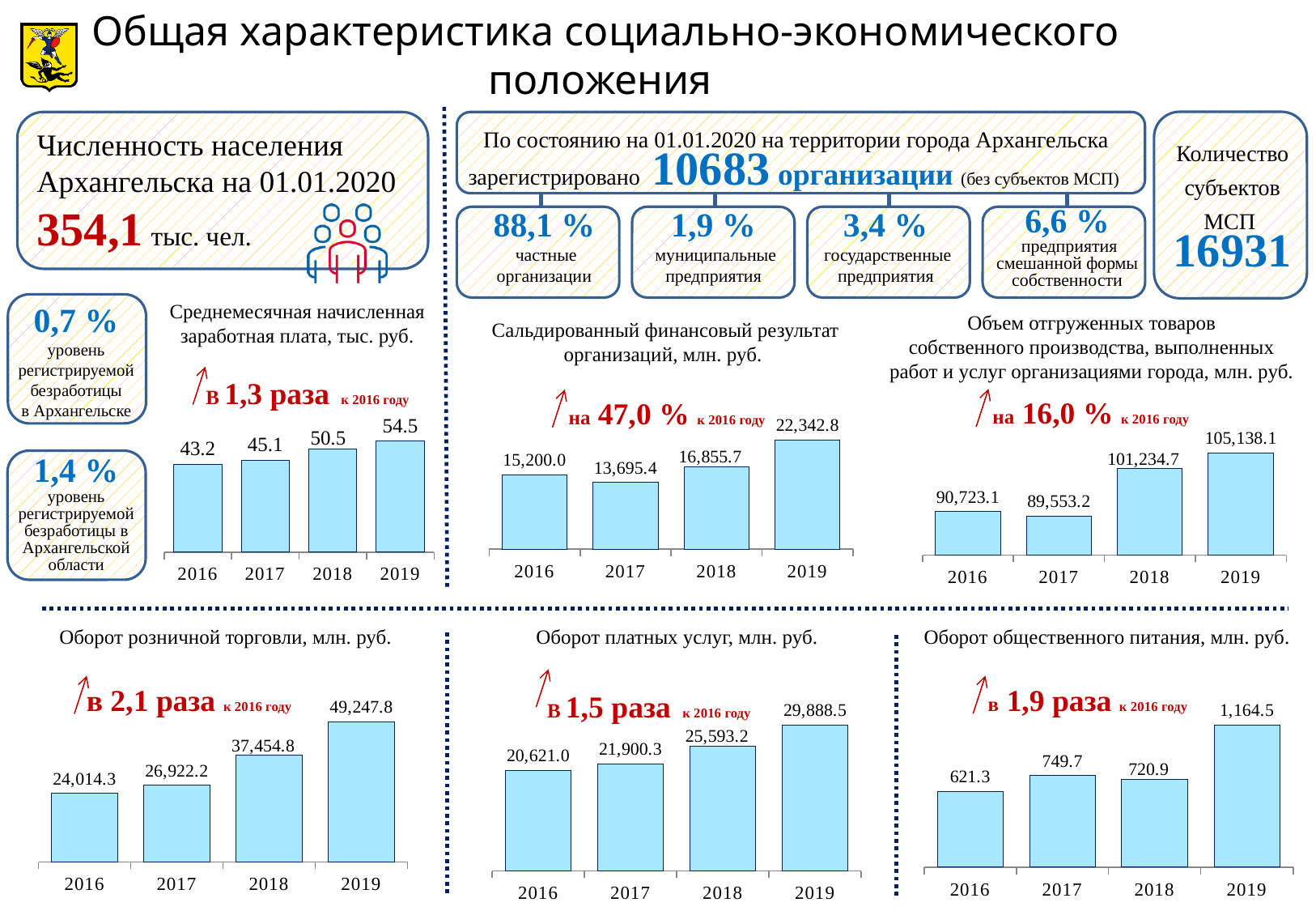
In the chart 'Сальдированный финансовый результат организаций, млн. руб.', what is the value for 2019? 22,342.8 In the chart 'Сальдированный финансовый результат организаций, млн. руб.', which year has the lowest value? 2017 How many years are shown in the chart 'Оборот платных услуг, млн. руб.'? 4 In the chart 'Оборот общественного питания, млн. руб.', what is the value for 2019? 1,164.5 In the chart 'Среднемесячная начисленная заработная плата, тыс. руб.', what is the value for 2019? 54.5 In the chart 'Оборот общественного питания, млн. руб.', which is larger, the value for 2017 or the value for 2018? 2017 In the chart 'Оборот платных услуг, млн. руб.', what is the value for 2016? 20,621.0 In the chart 'Объем отгруженных товаров собственного производства, выполненных работ и услуг организациями города, млн. руб.', which year has the highest value? 2019 In the chart 'Оборот розничной торговли, млн. руб.', what is the difference between the 2019 and 2018 values? 11,793.0 In the chart 'Объем отгруженных товаров собственного производства, выполненных работ и услуг организациями города, млн. руб.', what is the value for 2017? 89,553.2 What kind of chart is 'Среднемесячная начисленная заработная плата, тыс. руб.'? bar chart In the chart 'Оборот розничной торговли, млн. руб.', do the values rise or fall from 2016 to 2019? rise